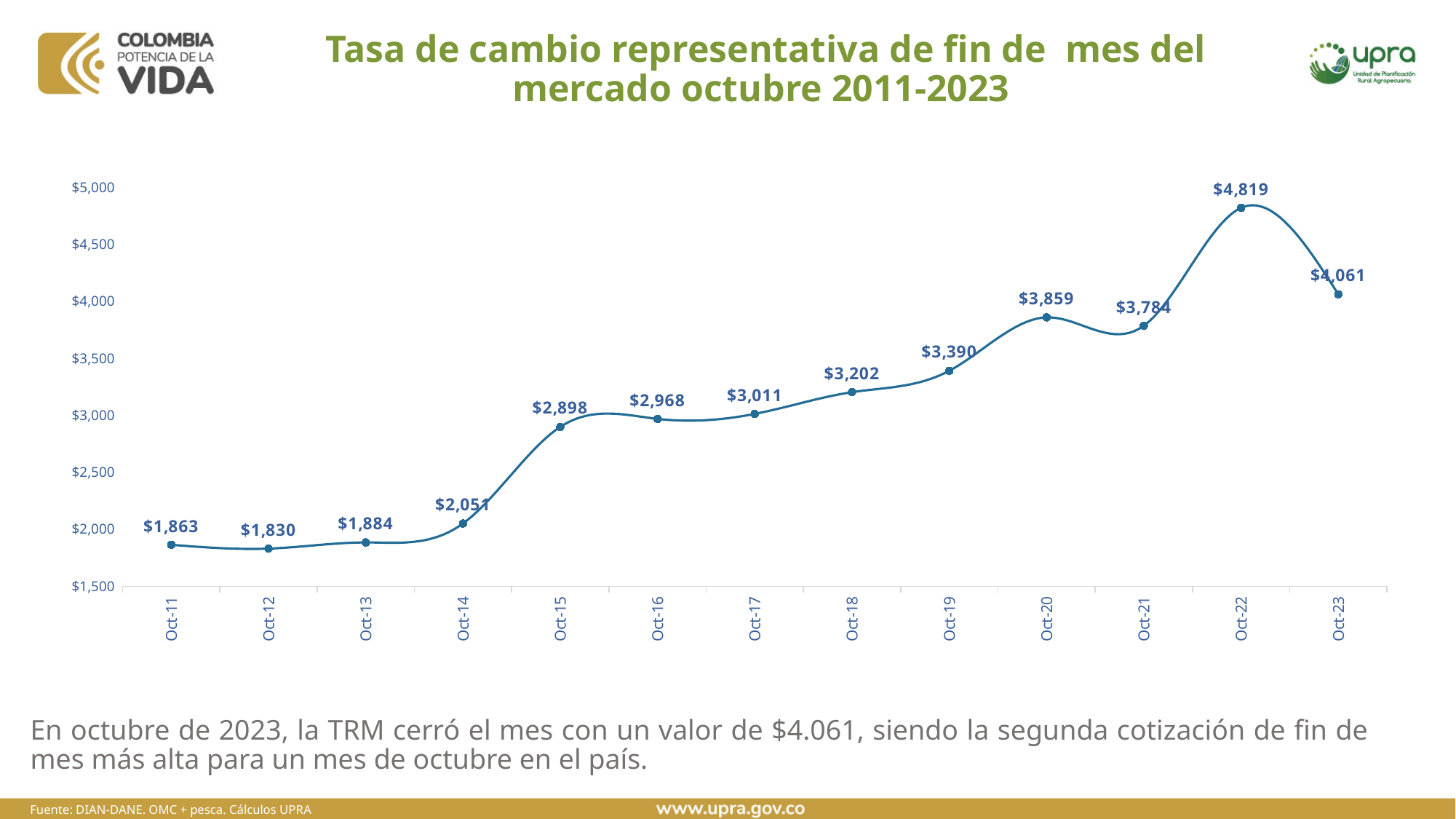
Which month has the highest value? Oct-22 How many data points are plotted on the chart? 13 What is the value for Oct-11? $1,863 Which is larger, the value for Oct-21 or the value for Oct-20? Oct-20 Do the values generally rise or fall from Oct-11 to Oct-22? Rise What is the value for Oct-15? $2,898 What is the value for Oct-20? $3,859 What is the title of the chart? Tasa de cambio representativa de fin de mes del mercado octubre 2011-2023 Which month has the lowest value? Oct-12 What kind of chart is shown on the slide? Line chart What is the difference between the values for Oct-22 and Oct-23? $758 What is the difference between the values for Oct-14 and Oct-13? $167